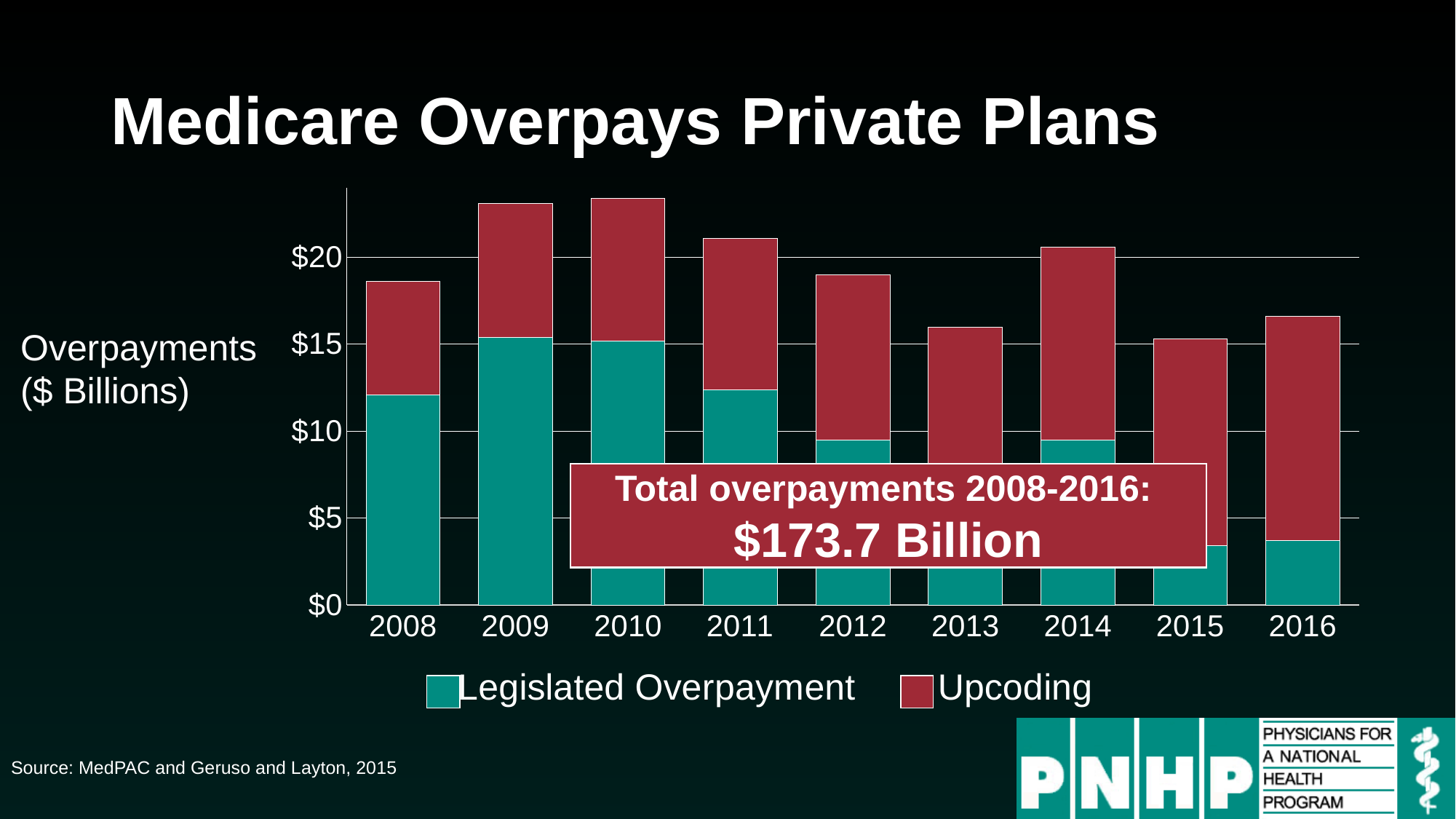
Is the total overpayment bar for 2013 greater or less than $20? less How many years are shown on the x axis of the chart? 9 Is the total overpayment bar for 2008 greater or less than $15? greater Does the Legislated Overpayment portion generally rise or fall from 2008 to 2016? fall Which year has the larger total overpayment bar, 2011 or 2015? 2011 Is the total overpayment bar for 2009 greater or less than $20? greater How many series does the chart's legend list? 2 What kind of chart is shown on the slide? Stacked bar chart What total overpayment figure for 2008-2016 is printed on the chart? $173.7 Billion Which year has the lowest total overpayment bar? 2015 What are the two series named in the legend? Legislated Overpayment and Upcoding